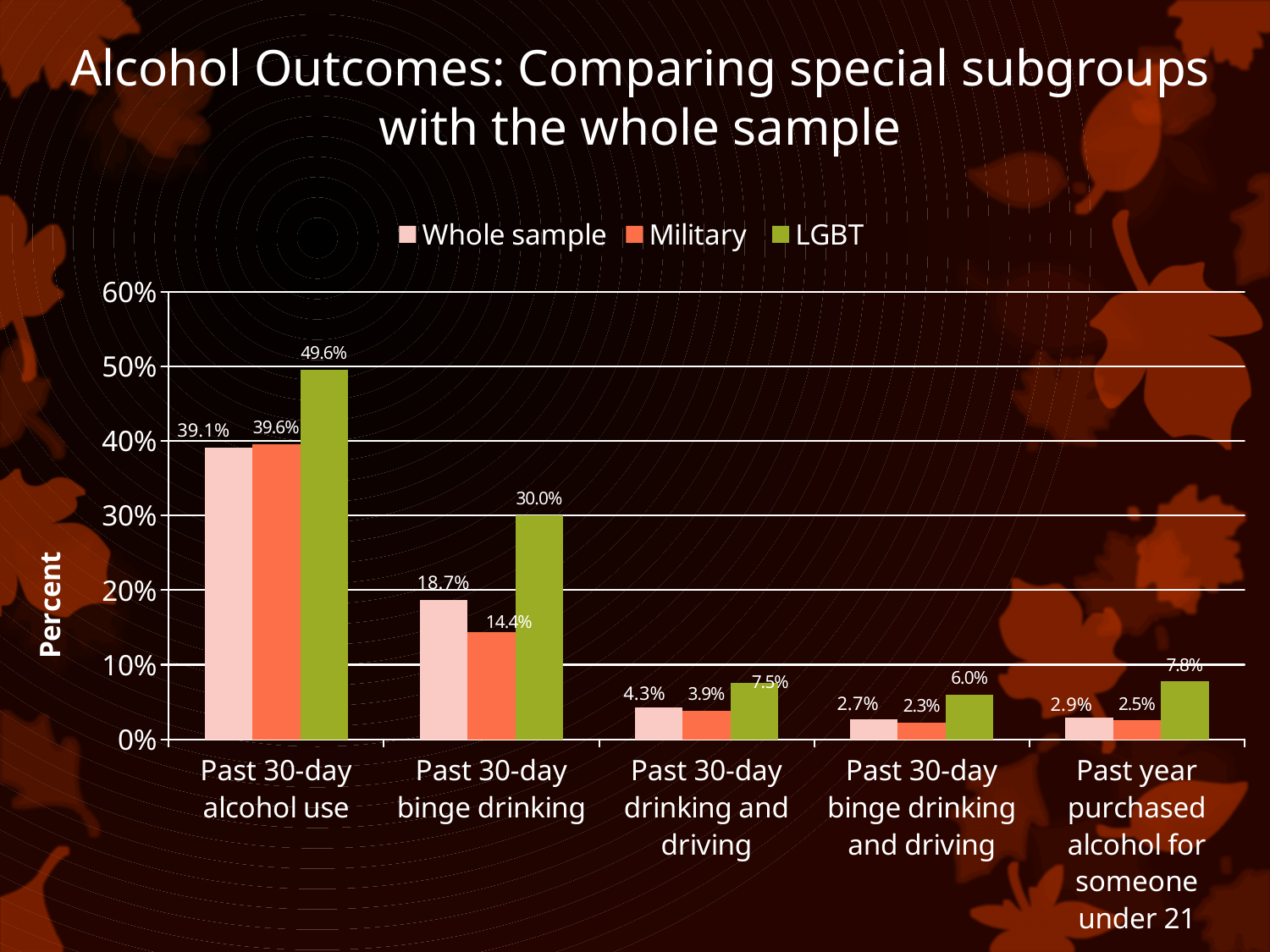
What is the Military value for Past 30-day drinking and driving? 3.9% What is the difference between the LGBT and Military values for Past 30-day binge drinking? 15.6% What is the Whole sample value for Past 30-day binge drinking? 18.7% What is the LGBT value for Past 30-day alcohol use? 49.6% Which category has the lowest Military value? Past 30-day binge drinking and driving For Past 30-day binge drinking, which is larger: the Whole sample value or the Military value? Whole sample What is the LGBT value for Past year purchased alcohol for someone under 21? 7.8% Which category has the highest Whole sample value? Past 30-day alcohol use How many series does the legend list? 3 Is the LGBT value for Past 30-day binge drinking greater or less than 20%? greater What kind of chart is shown on the slide? Bar chart How many categories are shown on the x axis? 5